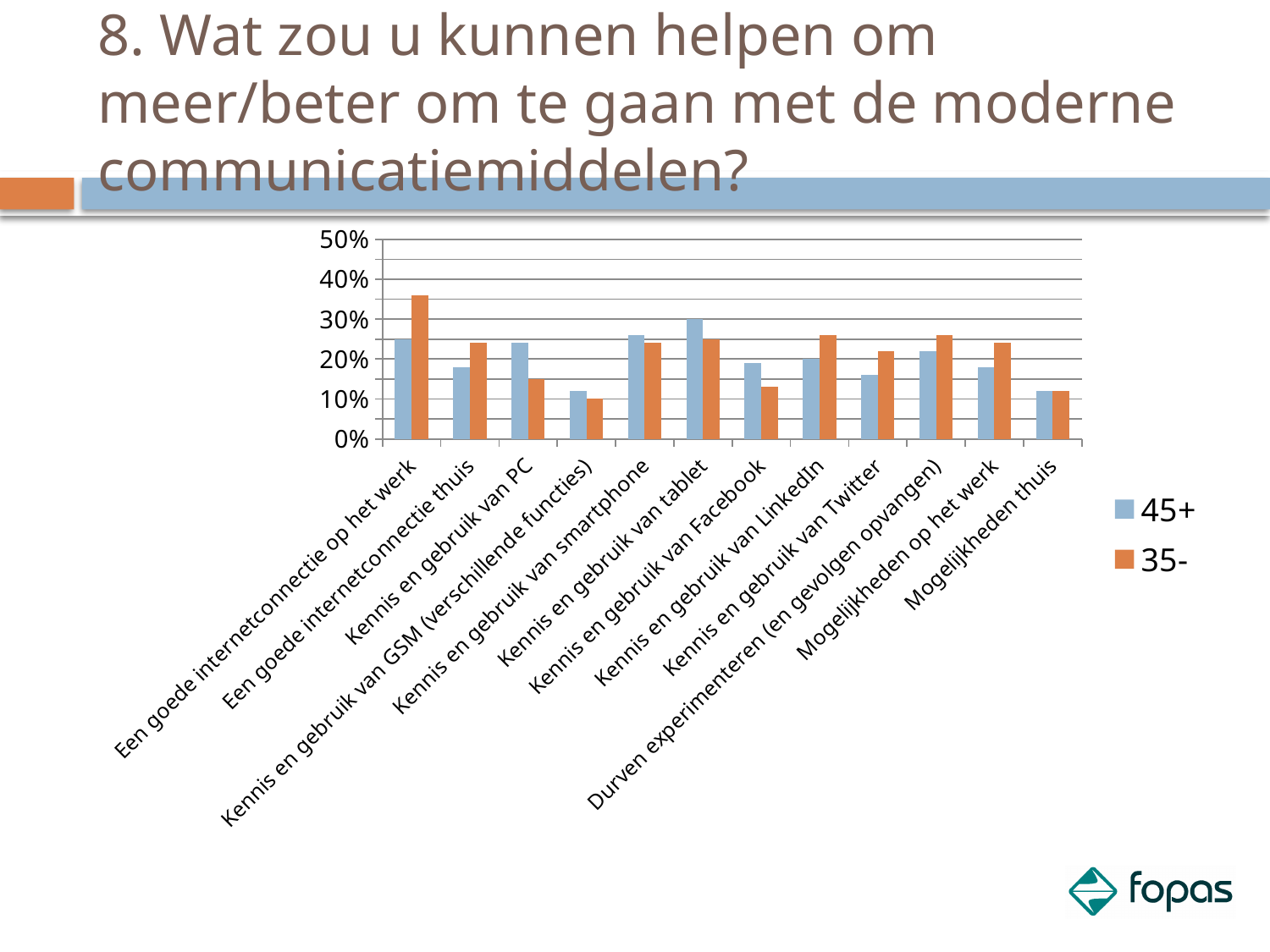
For 'Kennis en gebruik van Twitter', which series has the larger value, 45+ or 35-? 35- Which colour represents the 35- series in the chart? orange What kind of chart is shown on the slide? bar chart How many categories are shown on the x axis of the chart? 12 Is the 35- value for 'Een goede internetconnectie op het werk' greater or less than 30%? greater Which two series are listed in the chart's legend? 45+ and 35- Is the 45+ value for 'Kennis en gebruik van GSM (verschillende functies)' greater or less than 20%? less How many series does the chart's legend list? 2 For which category is the 45+ value highest? Kennis en gebruik van tablet Is the 45+ value for 'Kennis en gebruik van tablet' greater or less than 20%? greater For 'Kennis en gebruik van PC', which series has the larger value, 45+ or 35-? 45+ For which category is the 35- value highest? Een goede internetconnectie op het werk